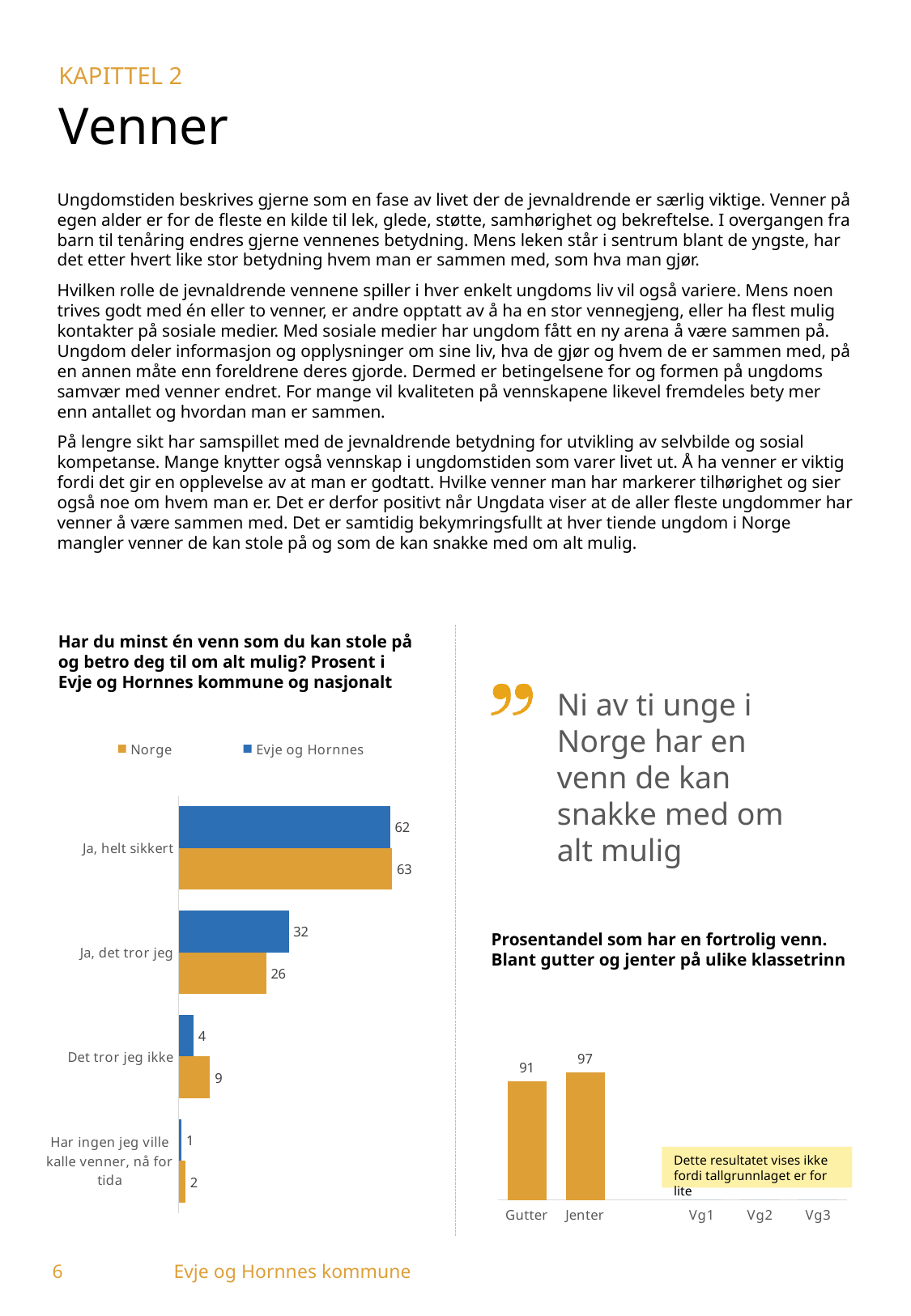
In the chart 'Prosentandel som har en fortrolig venn', what is the difference between Jenter and Gutter? 6 What kind of chart is 'Prosentandel som har en fortrolig venn. Blant gutter og jenter på ulike klassetrinn'? Bar chart In the chart 'Har du minst én venn som du kan stole på og betro deg til om alt mulig?', what is the value for Evje og Hornnes for 'Ja, helt sikkert'? 62 How many categories are shown in the chart 'Har du minst én venn som du kan stole på og betro deg til om alt mulig?'? 4 In the chart 'Har du minst én venn som du kan stole på og betro deg til om alt mulig?', which category has the highest value for Evje og Hornnes? Ja, helt sikkert In the chart 'Har du minst én venn som du kan stole på og betro deg til om alt mulig?', what is the value for Norge for 'Ja, det tror jeg'? 26 In the chart 'Har du minst én venn som du kan stole på og betro deg til om alt mulig?', which category has the lowest value for Norge? Har ingen jeg ville kalle venner, nå for tida How many series does the legend list in the chart 'Har du minst én venn som du kan stole på og betro deg til om alt mulig?'? 2 In the chart 'Prosentandel som har en fortrolig venn', what is the value for Jenter? 97 In the chart 'Har du minst én venn som du kan stole på og betro deg til om alt mulig?', what is the difference between Evje og Hornnes and Norge for 'Ja, det tror jeg'? 6 In the chart 'Har du minst én venn som du kan stole på og betro deg til om alt mulig?', what is the value for Norge for 'Det tror jeg ikke'? 9 In the chart 'Har du minst én venn som du kan stole på og betro deg til om alt mulig?', which is larger for 'Det tror jeg ikke': Norge or Evje og Hornnes? Norge